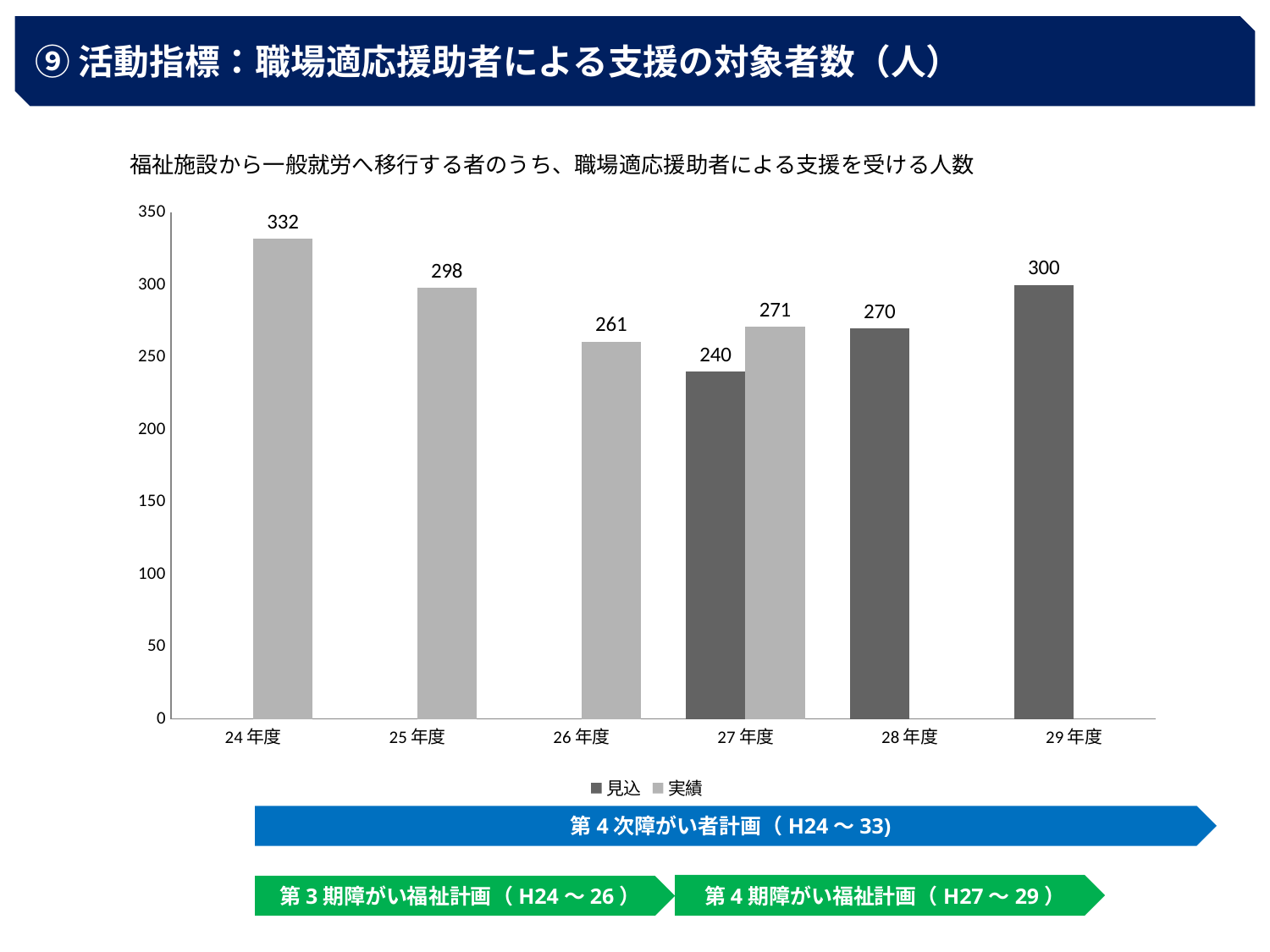
Which year has the highest 実績 value? 24年度 How many series does the legend list? 2 What kind of chart is shown? Bar chart What is the 見込 value for 27年度? 240 Do the 実績 values rise or fall from 24年度 to 26年度? Fall What is the difference between the 実績 and 見込 values for 27年度? 31 Which year has the lowest 実績 value? 26年度 Which is larger, the 実績 value for 25年度 or the 見込 value for 29年度? 29年度 見込 (300) What is the 実績 value for 27年度? 271 What is the 見込 value for 29年度? 300 How many year categories are shown on the x axis? 6 What is the 実績 value for 24年度? 332